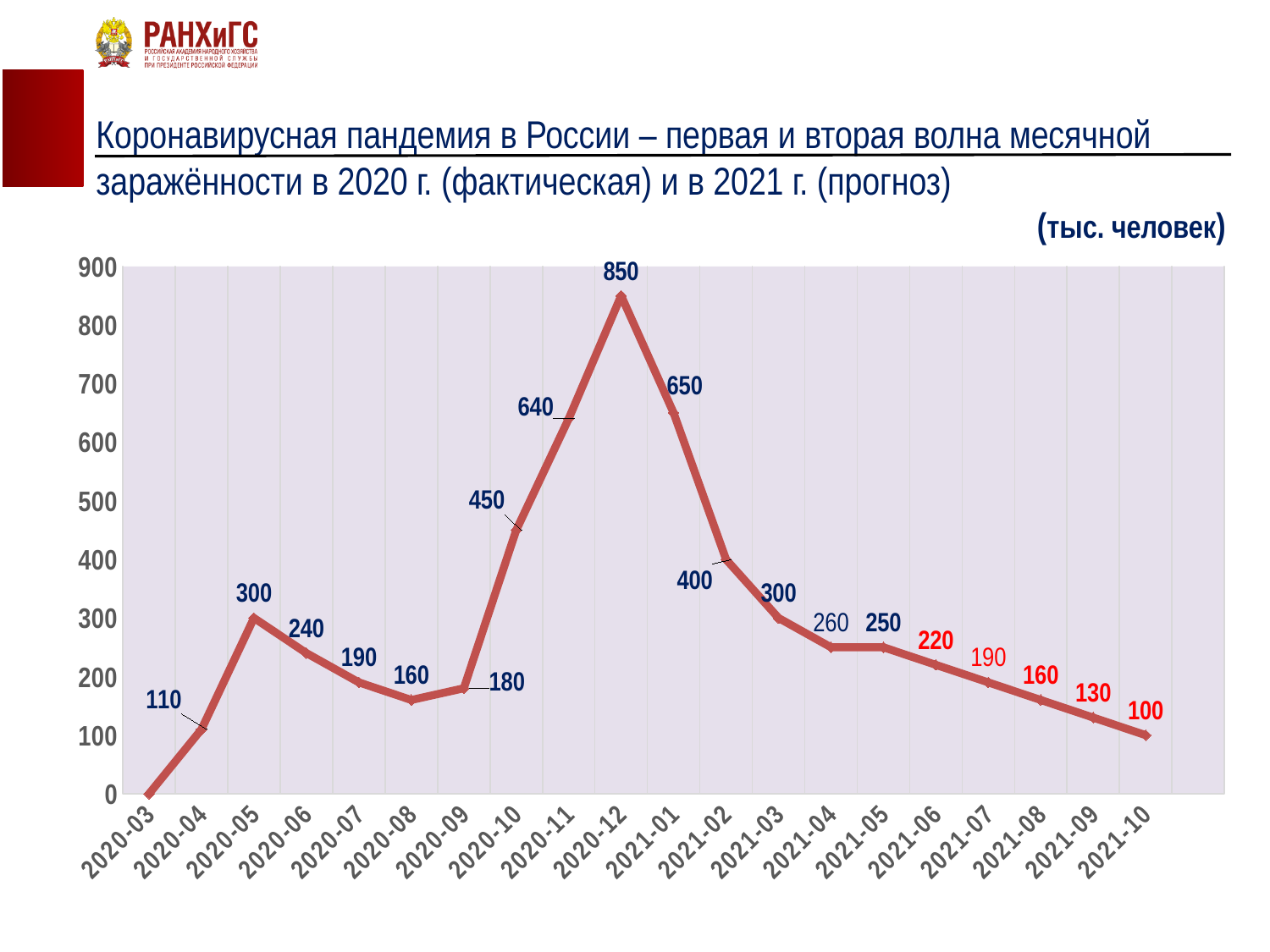
What is the difference between the values for 2020-12 and 2021-01? 200 How many months are plotted on the x axis? 20 What unit is stated above the chart? тыс. человек What is the value for 2020-12? 850 What type of chart is shown on the slide? line chart Which month has the highest value? 2020-12 Which month has the lowest value? 2020-03 What is the value for 2021-10? 100 Which is larger, the value for 2020-10 or the value for 2021-02? 2020-10 What is the value for 2020-05? 300 What is the difference between the values for 2020-05 and 2020-04? 190 Do the values rise or fall from 2021-01 to 2021-10? fall